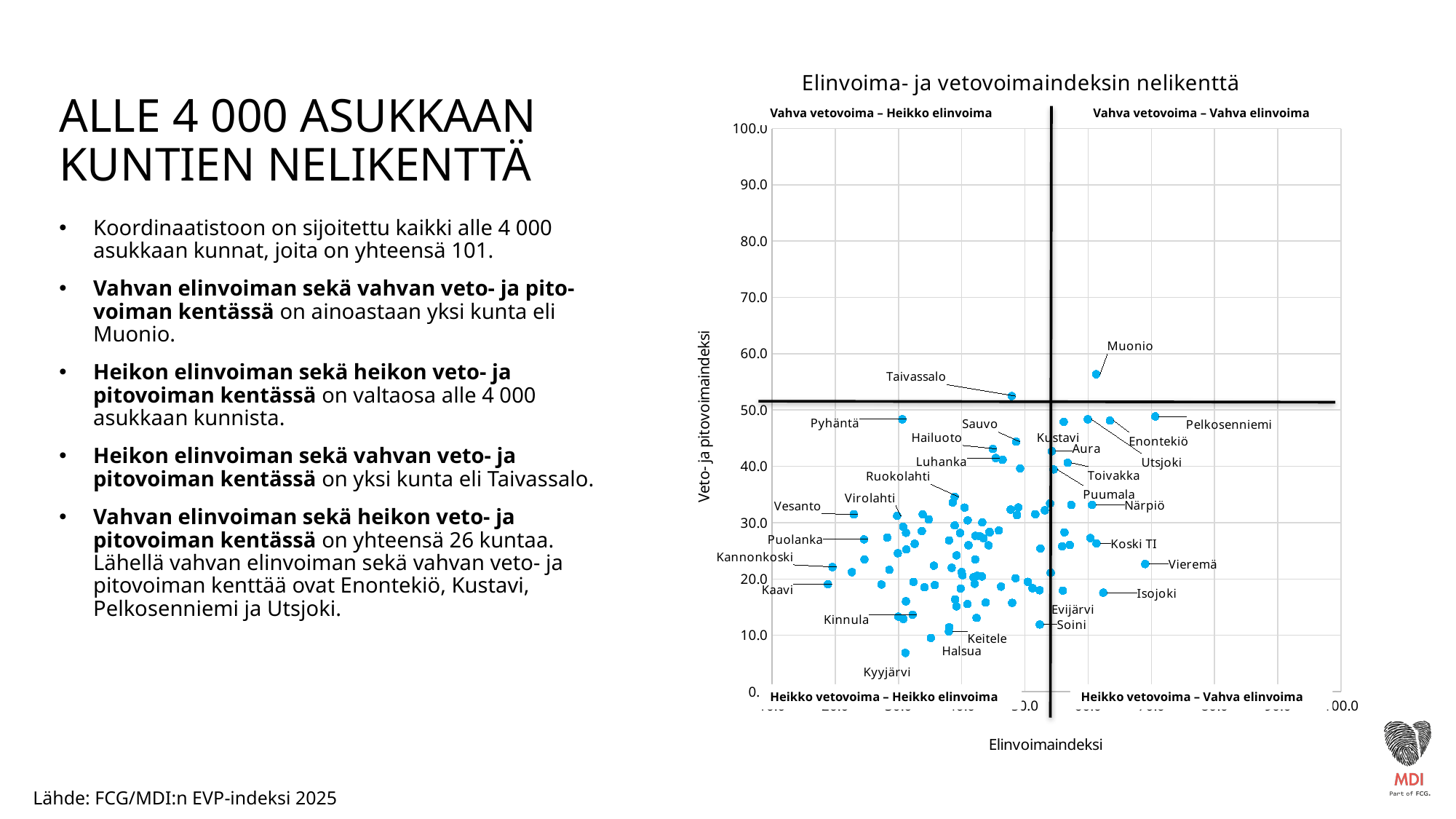
Which labelled municipality has the lowest Veto- ja pitovoimaindeksi value in the chart? Kyyjärvi What is the title of the chart? Elinvoima- ja vetovoimaindeksin nelikenttä What kind of chart is shown on the slide? Scatter chart Is the Veto- ja pitovoimaindeksi value for Muonio greater or less than 50? greater Is the Veto- ja pitovoimaindeksi value for Taivassalo greater or less than 40? greater Which labelled municipality has the highest Veto- ja pitovoimaindeksi value in the chart? Muonio Is the Veto- ja pitovoimaindeksi value for Kinnula greater or less than 20? less What is the label of the chart's vertical axis? Veto- ja pitovoimaindeksi Which has the higher Veto- ja pitovoimaindeksi value, Vesanto or Kinnula? Vesanto Which has the higher Veto- ja pitovoimaindeksi value, Muonio or Taivassalo? Muonio